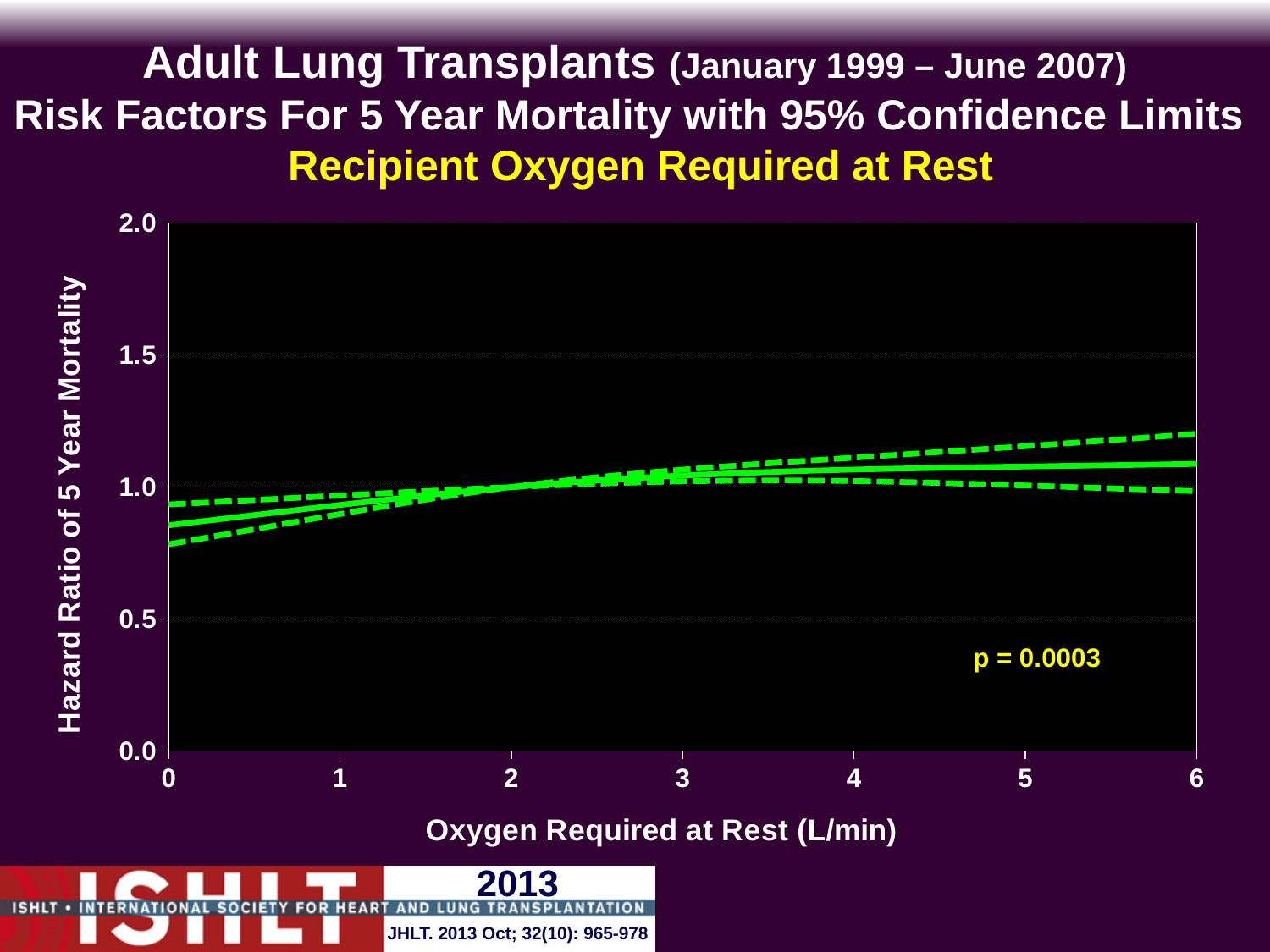
Is the upper 95% confidence limit at 6 L/min greater or less than 1.5? less What is the p-value shown on the chart? p = 0.0003 Is the hazard ratio at 0 L/min oxygen required at rest greater or less than 1.0? less Is the hazard ratio at 6 L/min oxygen required at rest greater or less than 1.0? greater What is the maximum value shown on the x axis? 6 What is the maximum value shown on the y axis? 2.0 Which has the larger hazard ratio, 0 L/min or 6 L/min oxygen required at rest? 6 L/min What kind of chart is shown on the slide? line chart How many lines are plotted on the chart (including the confidence limits)? 3 What is the label of the x axis? Oxygen Required at Rest (L/min) Does the hazard ratio of 5 year mortality rise or fall as oxygen required at rest increases from 0 to 6 L/min? rise